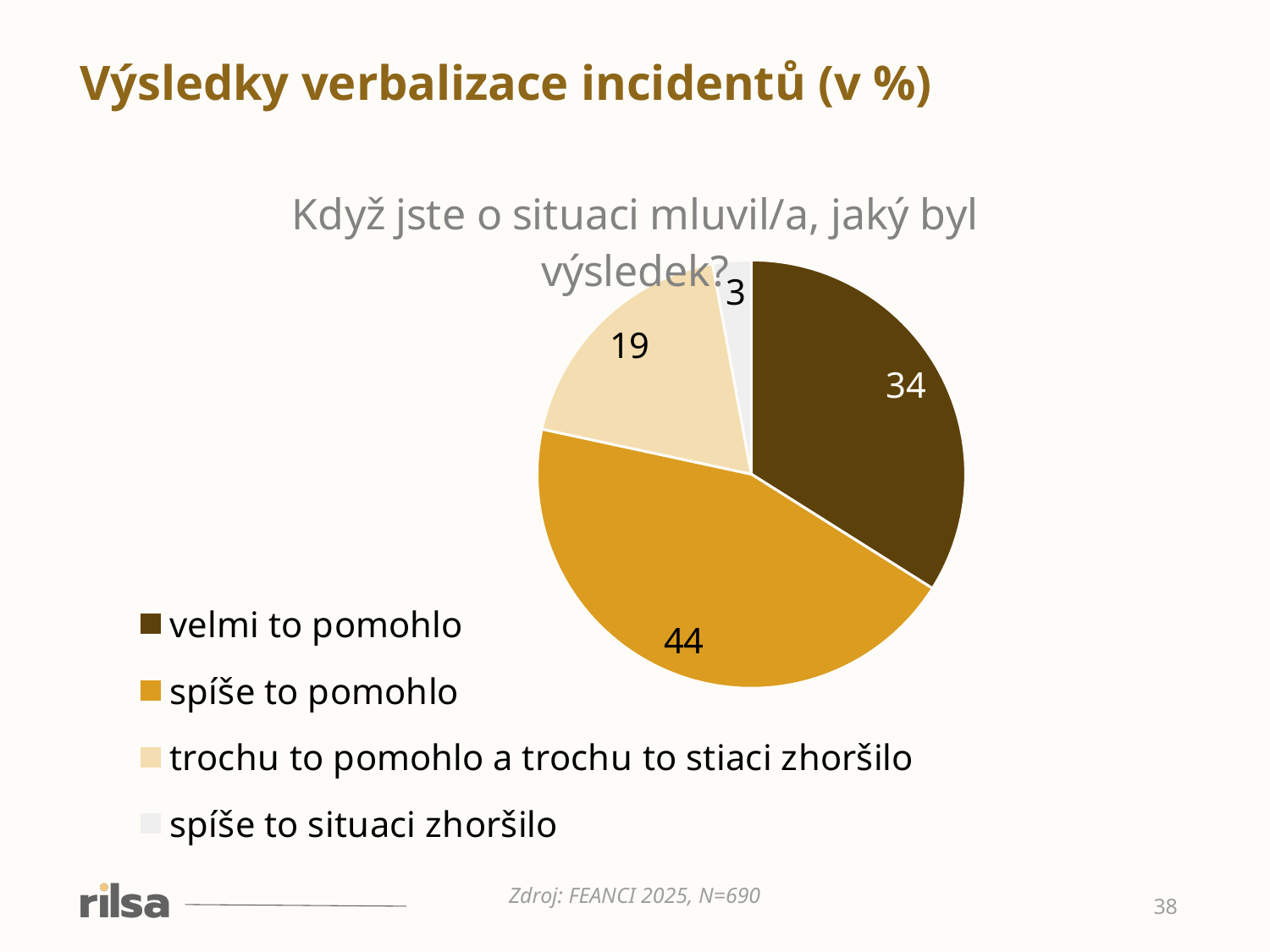
What is the value for "spíše to situaci zhoršilo"? 3 What is the combined value of "velmi to pomohlo" and "spíše to pomohlo"? 78 What is the value for "velmi to pomohlo"? 34 How many slices does the pie chart have? 4 What is the value for "spíše to pomohlo"? 44 What is the value for "trochu to pomohlo a trochu to stiaci zhoršilo"? 19 What is the title of the chart? Když jste o situaci mluvil/a, jaký byl výsledek? What is the difference between the values for "spíše to pomohlo" and "velmi to pomohlo"? 10 Which is larger, the value for "velmi to pomohlo" or the value for "trochu to pomohlo a trochu to stiaci zhoršilo"? velmi to pomohlo Which category has the smallest slice? spíše to situaci zhoršilo Which category has the largest slice? spíše to pomohlo What type of chart is shown on the slide? pie chart